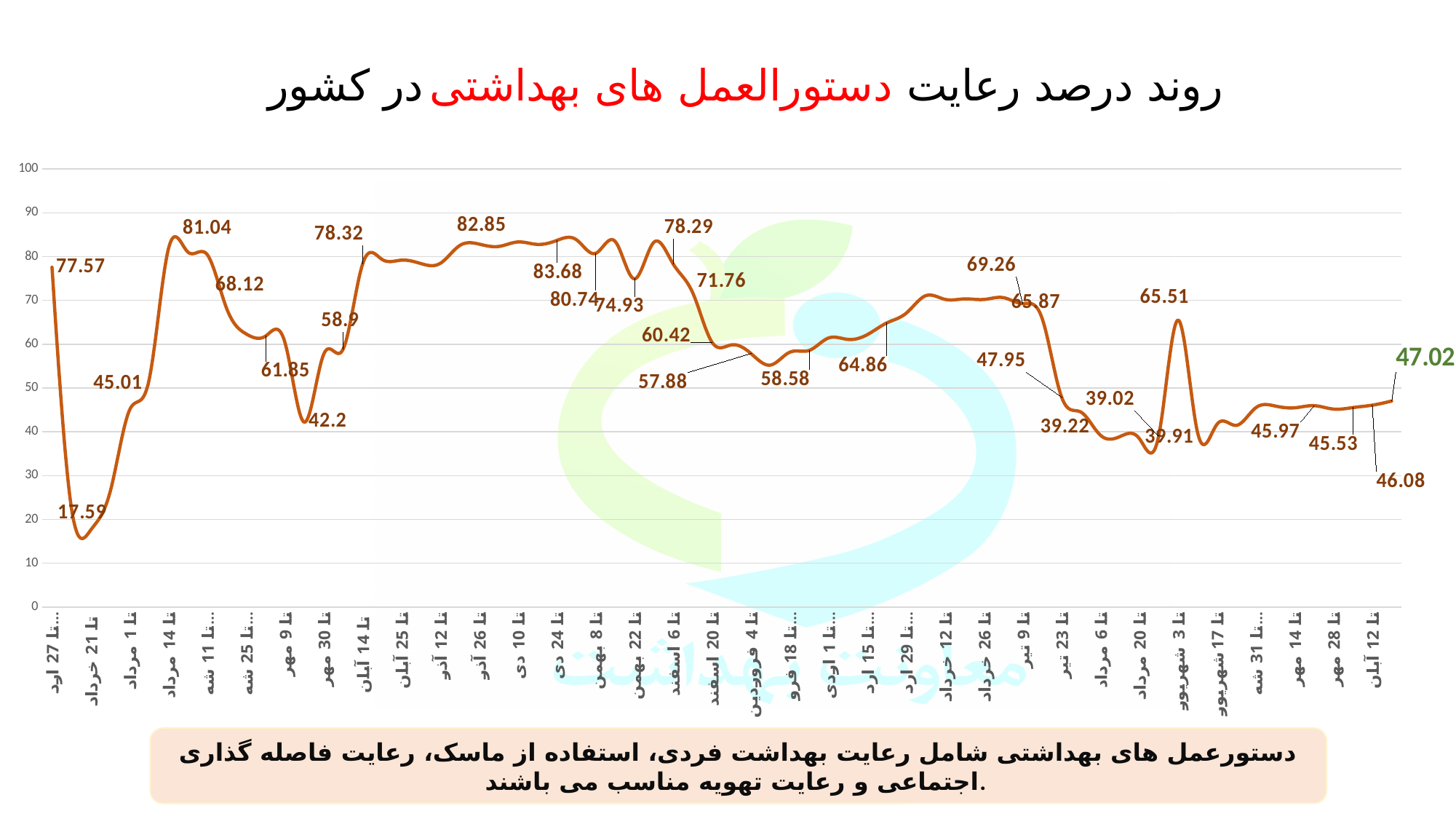
Which words of the chart title are written in red? دستورالعمل های بهداشتی Is the value of the line at تا 21 خرداد greater or less than 20? less What is the value labelled at the first point on the left of the line? 77.57 Does the line rise or fall between تا 9 تیر and تا 23 تیر? fall Which labelled value is larger, 82.85 or 78.32? 82.85 What is the difference between the labelled values 65.51 and 39.91? 25.6 How many lines are plotted on the chart? 1 What is the value of the final (green-labelled) point at the right end of the line? 47.02 What kind of chart is shown on the slide? line chart Is the value of the line at تا 14 مرداد greater or less than 80? greater What is the difference between the first labelled value (77.57) and the last labelled value (47.02)? 30.55 What is the lowest value labelled on the chart? 17.59